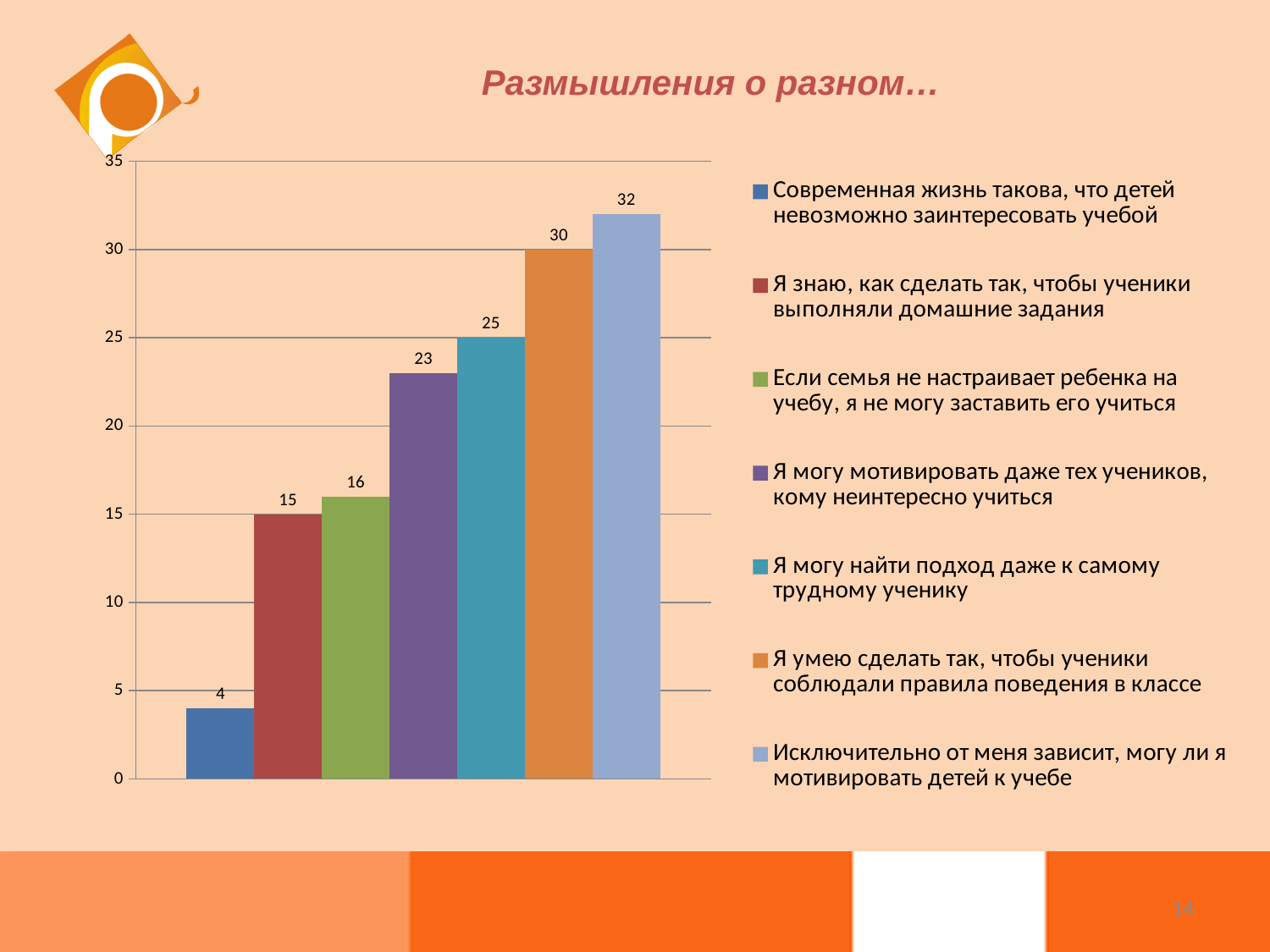
How many series does the legend list? 7 Which series has the highest value? Исключительно от меня зависит, могу ли я мотивировать детей к учебе What is the difference between the values for "Исключительно от меня зависит, могу ли я мотивировать детей к учебе" and "Я могу мотивировать даже тех учеников, кому неинтересно учиться"? 9 What kind of chart is shown on the slide? bar chart What is the value for "Современная жизнь такова, что детей невозможно заинтересовать учебой"? 4 Which series has the lowest value? Современная жизнь такова, что детей невозможно заинтересовать учебой Which is larger: the value for "Я знаю, как сделать так, чтобы ученики выполняли домашние задания" or for "Если семья не настраивает ребенка на учебу, я не могу заставить его учиться"? Если семья не настраивает ребенка на учебу, я не могу заставить его учиться Is the value for "Я могу мотивировать даже тех учеников, кому неинтересно учиться" greater or less than 20? greater How many bars are plotted on the chart? 7 What is the value for "Я умею сделать так, чтобы ученики соблюдали правила поведения в классе"? 30 What is the title of the slide? Размышления о разном… What is the value for "Я могу найти подход даже к самому трудному ученику"? 25